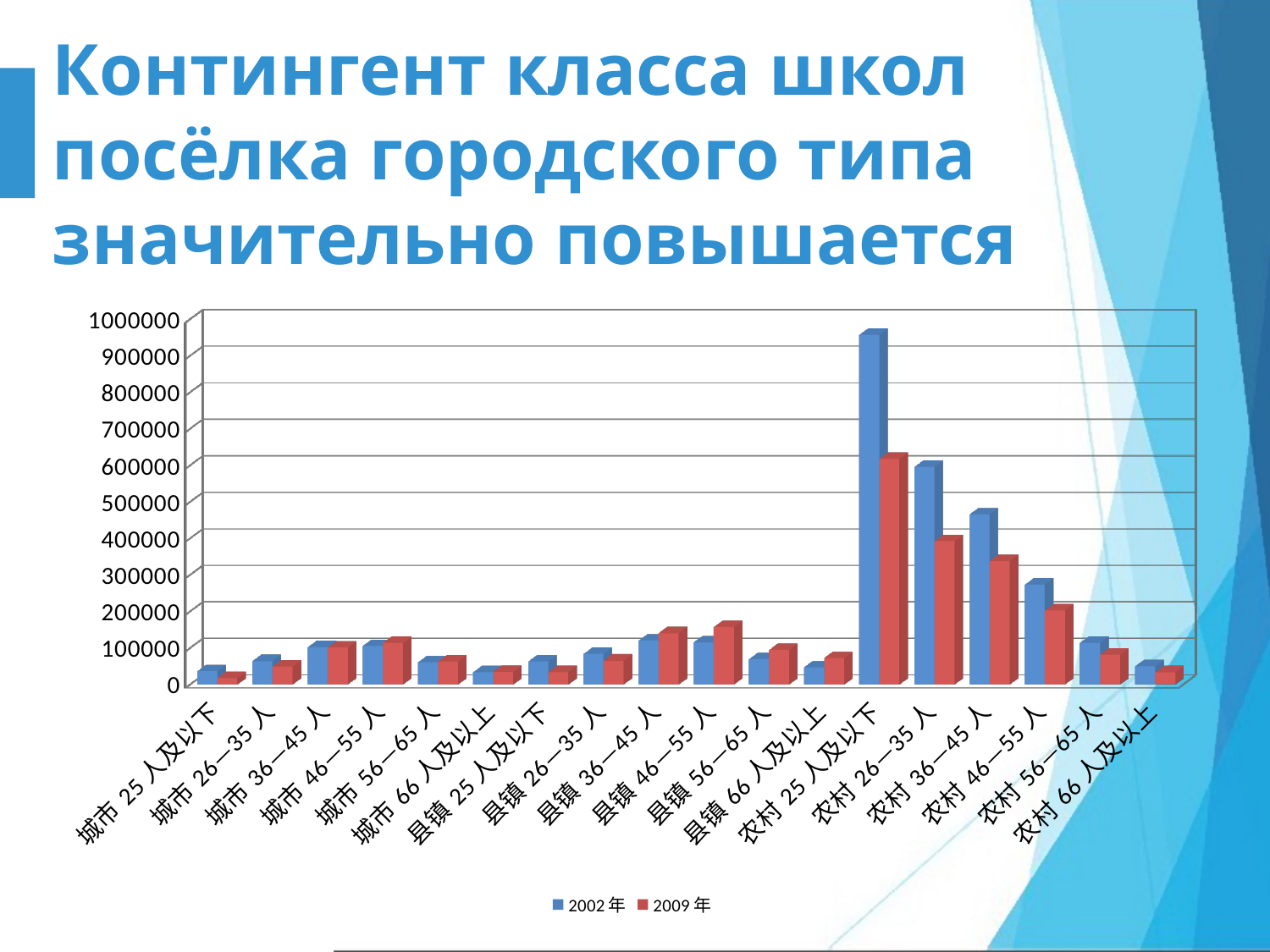
Is the 2002年 value for 农村 26—35人 greater or less than 500000? greater What are the two series named in the legend? 2002年 and 2009年 How many series does the legend list? 2 Is the 2002年 value for 农村 25人及以下 greater or less than 900000? greater Is the 2009年 value for 农村 46—55人 greater or less than 300000? less For 农村 25人及以下, which series has the larger value, 2002年 or 2009年? 2002年 Which category has the highest value for the 2002年 series? 农村 25人及以下 What kind of chart is shown on the slide? bar chart How many categories are shown along the x axis? 18 For 县镇 46—55人, which series has the larger value, 2002年 or 2009年? 2009年 Which category has the highest value for the 2009年 series? 农村 25人及以下